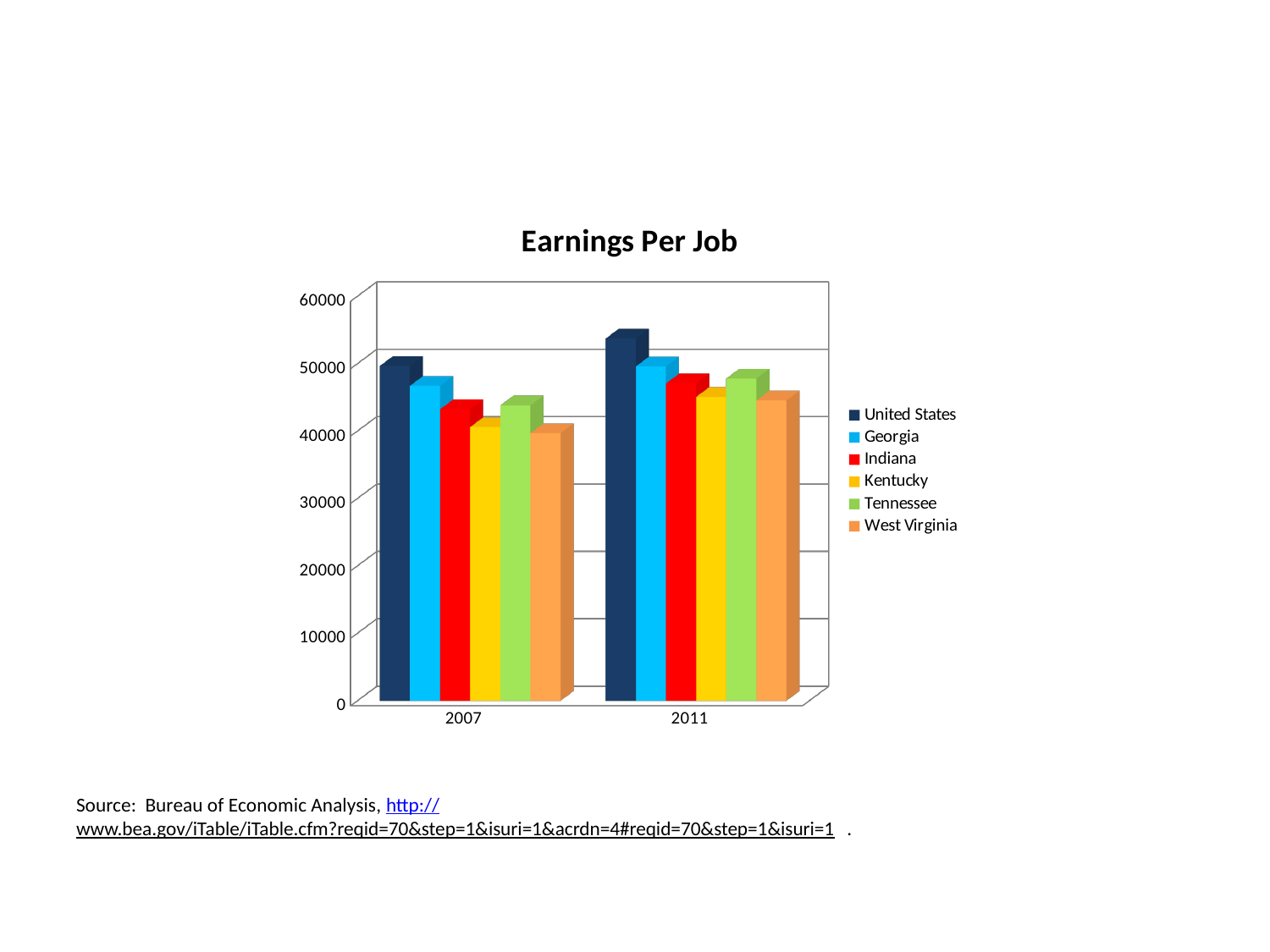
Which is larger in 2007, the value for United States or the value for Georgia? United States Which series has the highest earnings per job in 2007? United States Is the value for Georgia in 2007 greater or less than 40000? greater What is the title of the chart? Earnings Per Job Is the value for Indiana in 2011 greater or less than 50000? less How many series does the legend list? 6 Does the value for United States rise or fall from 2007 to 2011? rise What kind of chart is shown on the slide? bar chart Which series has the highest earnings per job in 2011? United States How many year categories are shown on the x axis? 2 Which series is shown in red in the legend? Indiana Is the value for United States in 2011 greater or less than 50000? greater